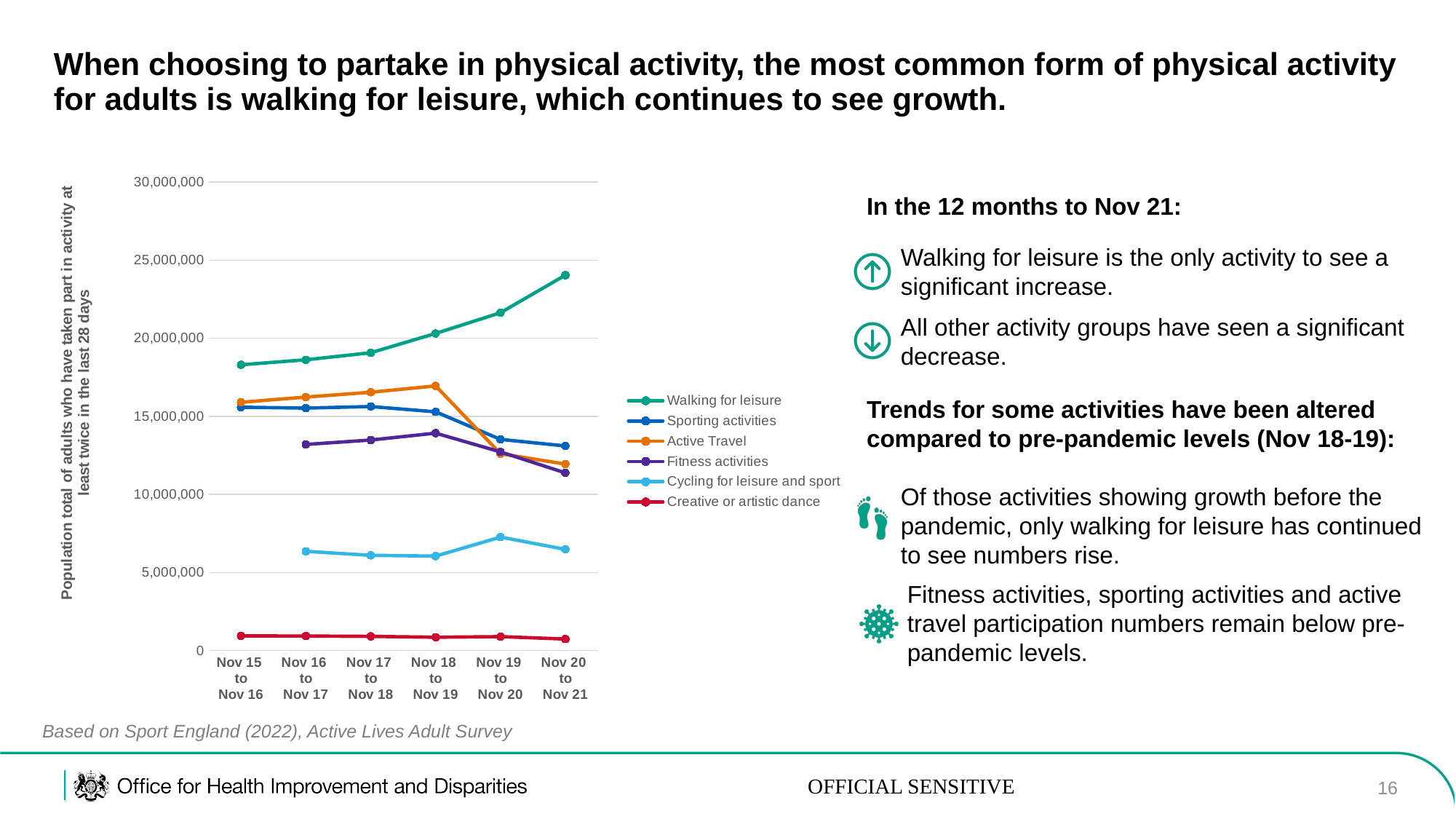
How many series does the legend list? 6 Is the value for Creative or artistic dance in Nov 18 to Nov 19 greater or less than 5,000,000? less Which activity has the lowest value across all periods shown? Creative or artistic dance What kind of chart is shown on the slide? line chart In Nov 20 to Nov 21, which is larger: Sporting activities or Fitness activities? Sporting activities Is the value for Cycling for leisure and sport in Nov 19 to Nov 20 greater or less than 10,000,000? less Does the Active Travel line rise or fall from Nov 18 to Nov 19 through Nov 20 to Nov 21? fall Does the Walking for leisure line rise or fall from Nov 15 to Nov 16 through Nov 20 to Nov 21? rise How many series have a data point in the Nov 15 to Nov 16 period? 4 How many time periods are shown on the x axis? 6 Is the value for Walking for leisure in Nov 20 to Nov 21 greater or less than 20,000,000? greater Which activity has the highest value in the Nov 20 to Nov 21 period? Walking for leisure